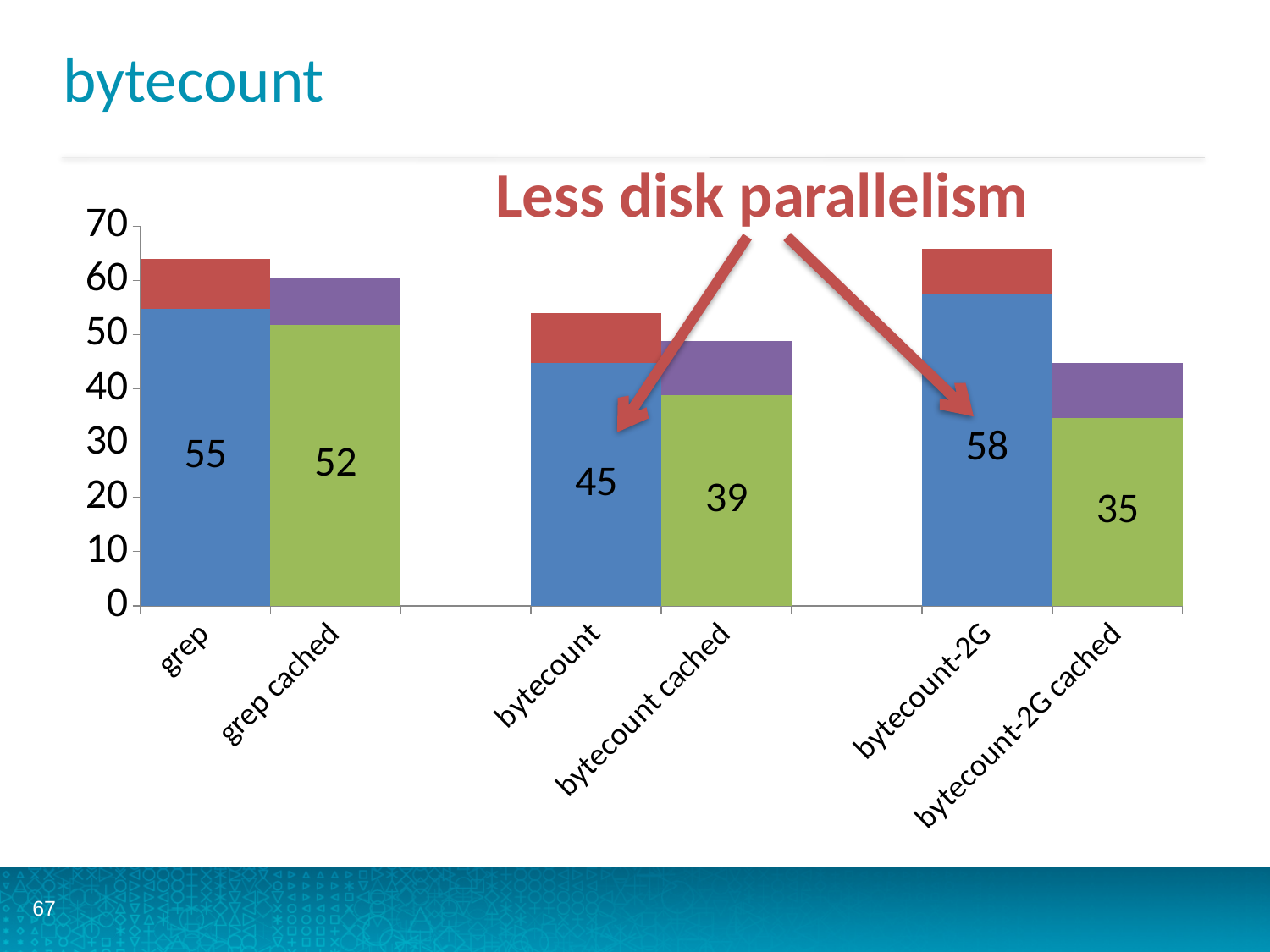
What is the labeled value of the bottom segment of the bytecount-2G cached bar? 35 What annotation text is written in red above the chart? Less disk parallelism What kind of chart is shown on the slide? stacked bar chart What is the labeled value of the bottom segment of the bytecount cached bar? 39 How many categories are shown on the x axis? 6 Which category has the highest labeled bottom-segment value? bytecount-2G Is the total height of the bytecount-2G stacked bar greater or less than 60? greater What is the difference between the labeled bottom-segment values for bytecount and bytecount cached? 6 Which category has the lowest labeled bottom-segment value? bytecount-2G cached Which has a larger labeled bottom-segment value, grep or grep cached? grep What is the labeled value of the bottom segment of the bytecount-2G bar? 58 What is the labeled value of the bottom segment of the grep bar? 55